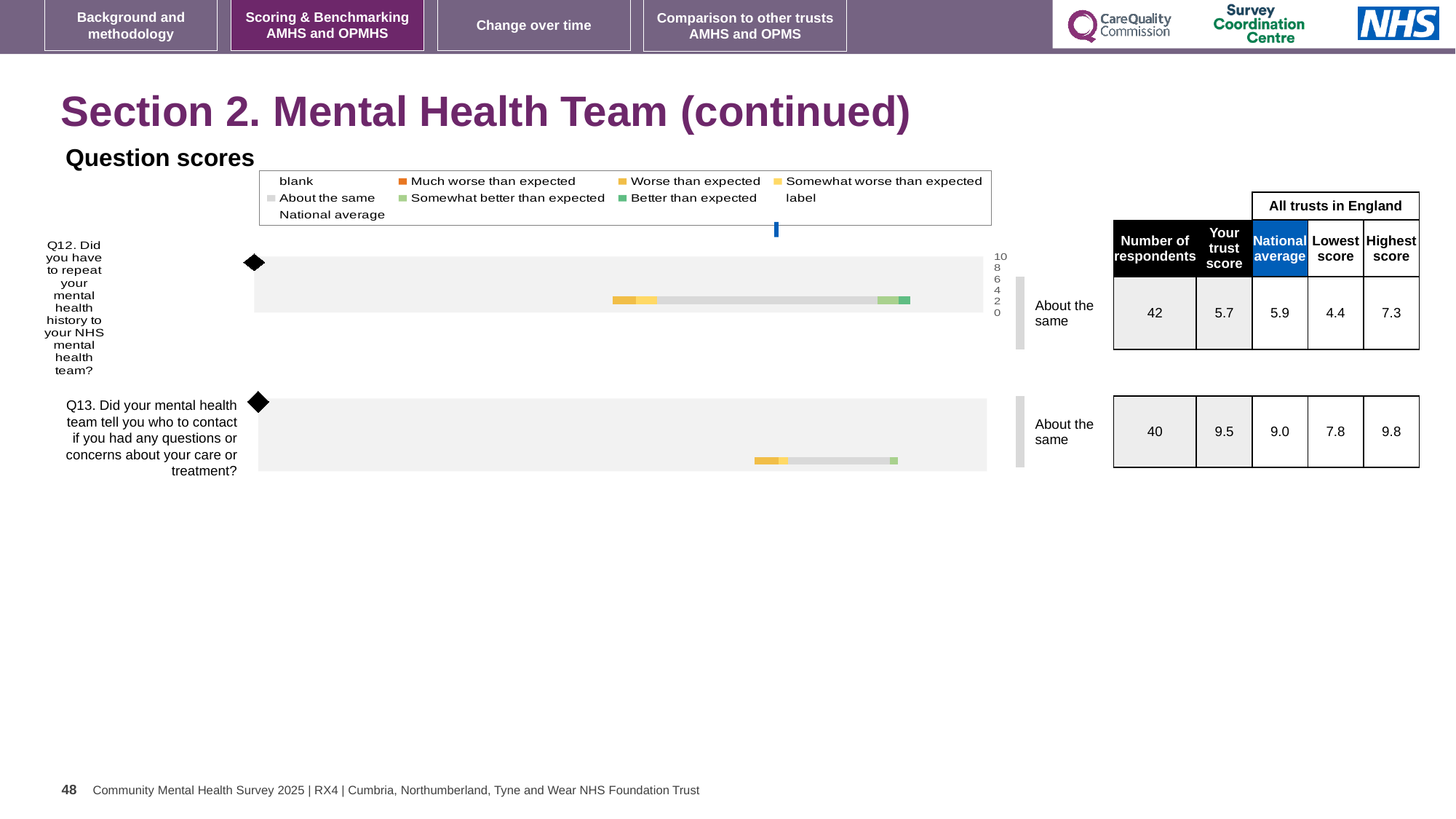
What is the trust's score for Q12 (repeating mental health history)? 5.7 Which of the two questions has the higher trust score, Q12 or Q13? Q13 What benchmark category is shown for Q12? About the same Which is larger for Q13: the trust's score or the national average? The trust's score (9.5) How many respondents answered Q12? 42 What is the national average score for Q13 (told who to contact with questions or concerns)? 9.0 What is the highest score among all trusts in England for Q13? 9.8 What type of chart is used to show the question scores? Bar chart How many questions are plotted on this slide? 2 What is the difference between the trust's score and the national average for Q13? 0.5 What is the lowest score among all trusts in England for Q12? 4.4 What is the difference between the highest and lowest scores across all trusts in England for Q12? 2.9